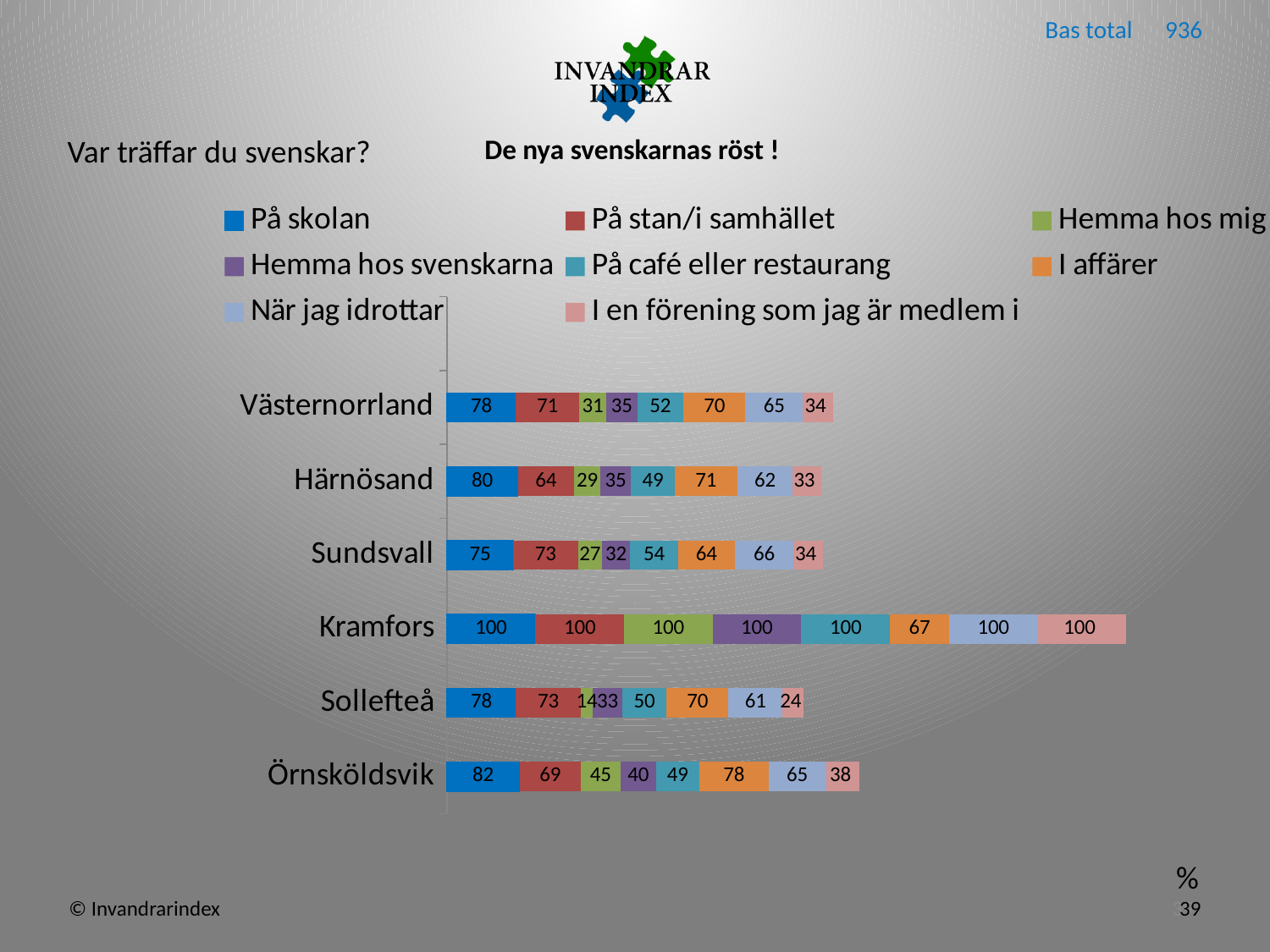
How many categories (regions/municipalities) are shown in the chart? 6 What is the total of all segments in the Kramfors bar? 767 What is the value for På café eller restaurang in Sundsvall? 54 What is the value for På skolan in Härnösand? 80 Which has the larger value for I affärer, Härnösand or Sundsvall? Härnösand Which category has the highest value for På skolan? Kramfors In Västernorrland, what is the difference between the På skolan value and the På stan/i samhället value? 7 What is the value for När jag idrottar in Sollefteå? 61 What kind of chart is shown on the slide? Stacked bar chart What is the value for I affärer in Örnsköldsvik? 78 Which category has the lowest value for Hemma hos mig? Sollefteå How many series does the legend list? 8